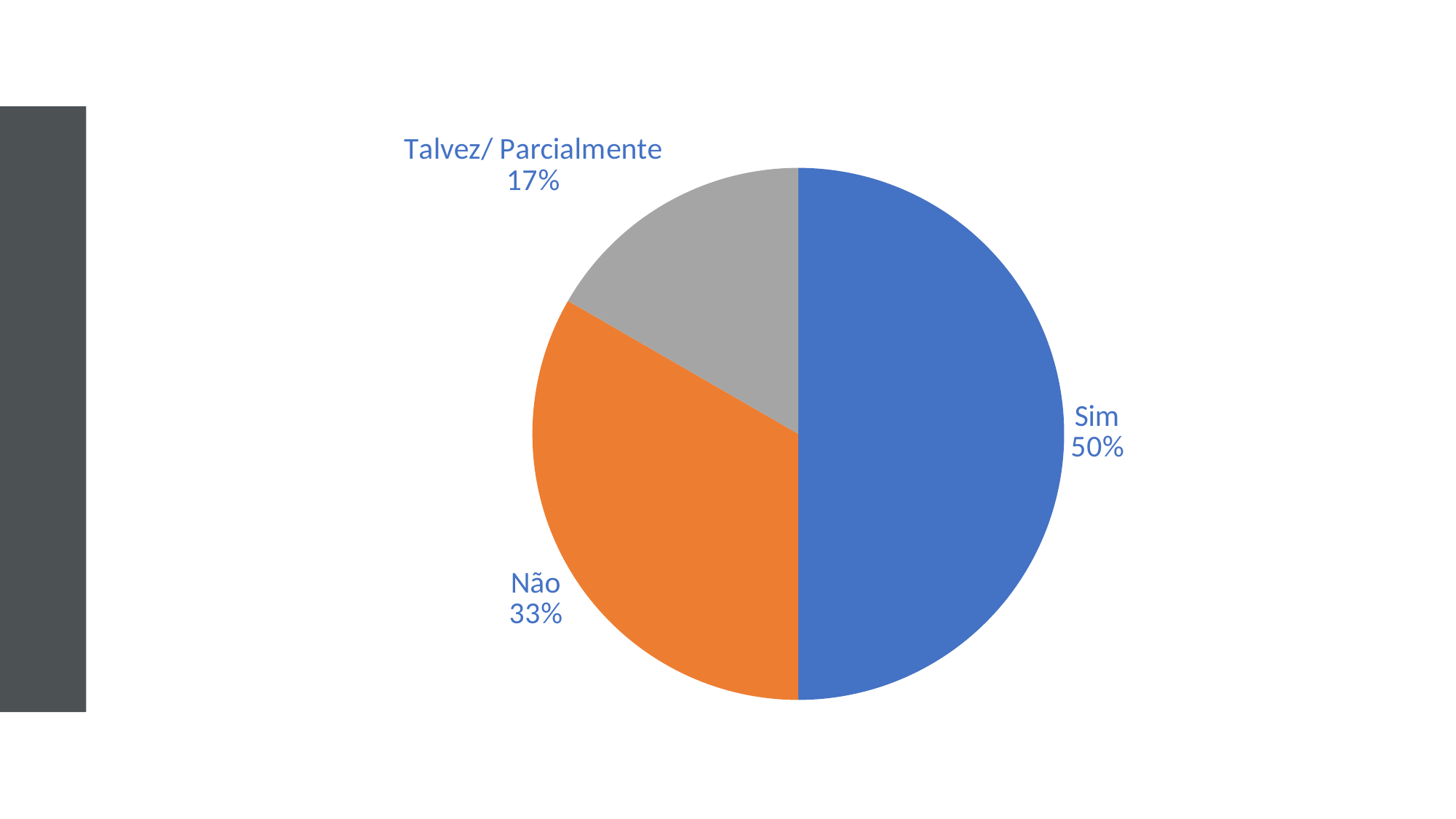
What share of the pie does the "Sim" slice represent? 50% What kind of chart is shown on the slide? pie chart What share of the pie does the "Talvez/ Parcialmente" slice represent? 17% Which slice is larger, "Não" or "Talvez/ Parcialmente"? Não What share of the pie does the "Não" slice represent? 33% What is the difference in percentage points between the "Não" and "Talvez/ Parcialmente" slices? 16 What colour is the "Não" slice? orange How many slices does the pie chart have? 3 Which category has the smallest slice of the pie? Talvez/ Parcialmente What colour is the "Sim" slice? blue Which category has the largest slice of the pie? Sim What is the difference in percentage points between the "Sim" and "Não" slices? 17